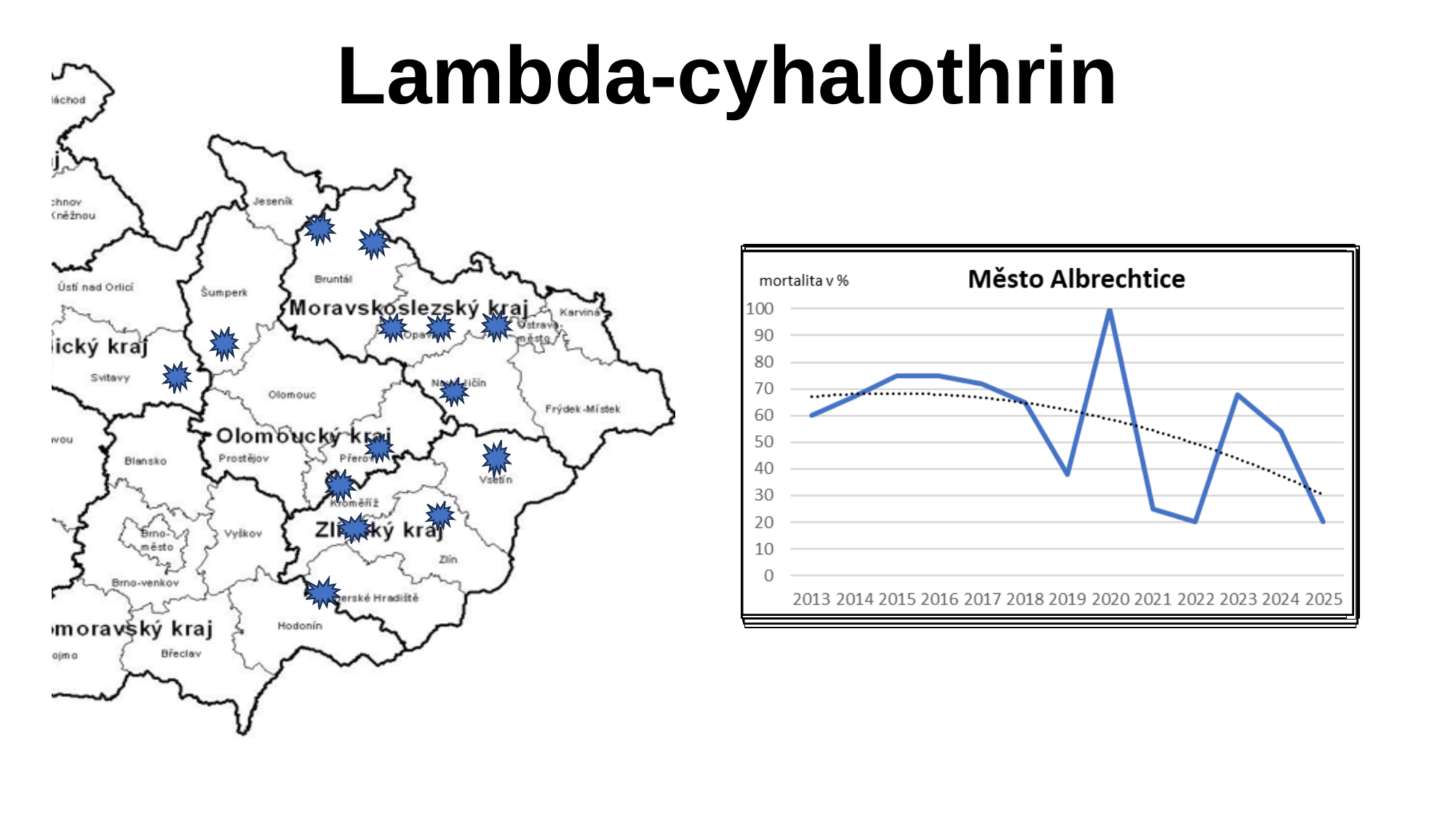
In which year does the chart reach its highest mortality value? 2020 Do the values rise or fall from 2023 to 2025? fall What is the mortality value for 2020? 100 Is the value for 2021 greater or less than 30? less What kind of chart is shown on the slide? line chart Which year has the larger value, 2015 or 2021? 2015 What is the title of the chart? Město Albrechtice What label is shown for the vertical axis of the chart? mortalita v % Is the value for 2019 greater or less than 50? less How many years are plotted along the x axis of the chart? 13 Is the value for 2015 greater or less than 70? greater